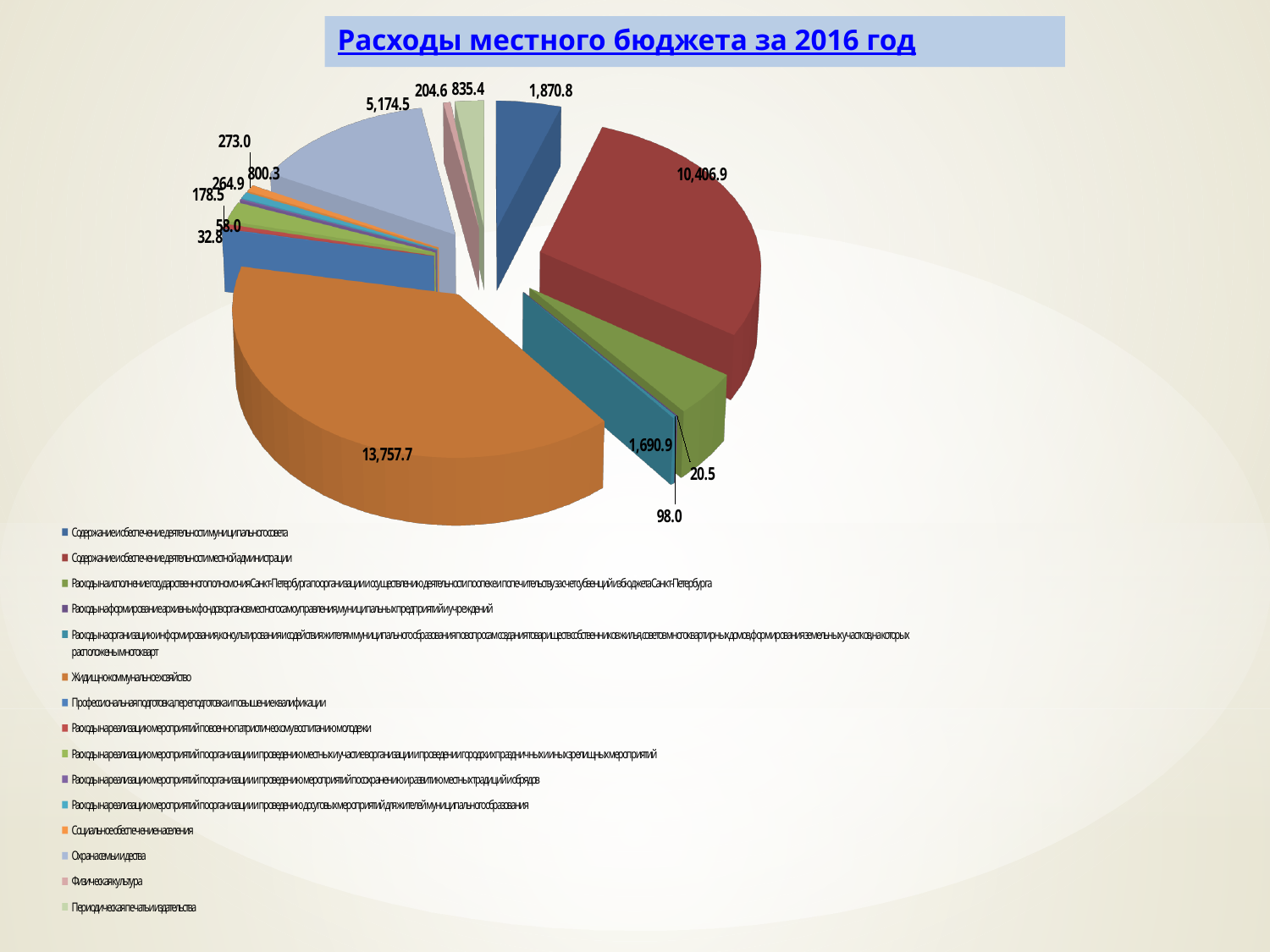
How many entries does the legend list? 15 What is the value labelled on the largest slice of the pie? 13,757.7 Which is larger, the slice labelled 1,870.8 or the slice labelled 1,690.9? 1,870.8 What is the difference between the two largest slice values, 13,757.7 and 10,406.9? 3,350.8 What is the value for Жилищно-коммунальное хозяйство? 13,757.7 What is the title of the chart? Расходы местного бюджета за 2016 год How many slices does the pie chart have? 15 What is the smallest value labelled on the pie chart? 20.5 What is the difference between the slices labelled 835.4 and 204.6? 630.8 What kind of chart is shown on the slide? pie chart What is the value for Охрана семьи и детства? 5,174.5 What colour is the largest slice of the pie? orange